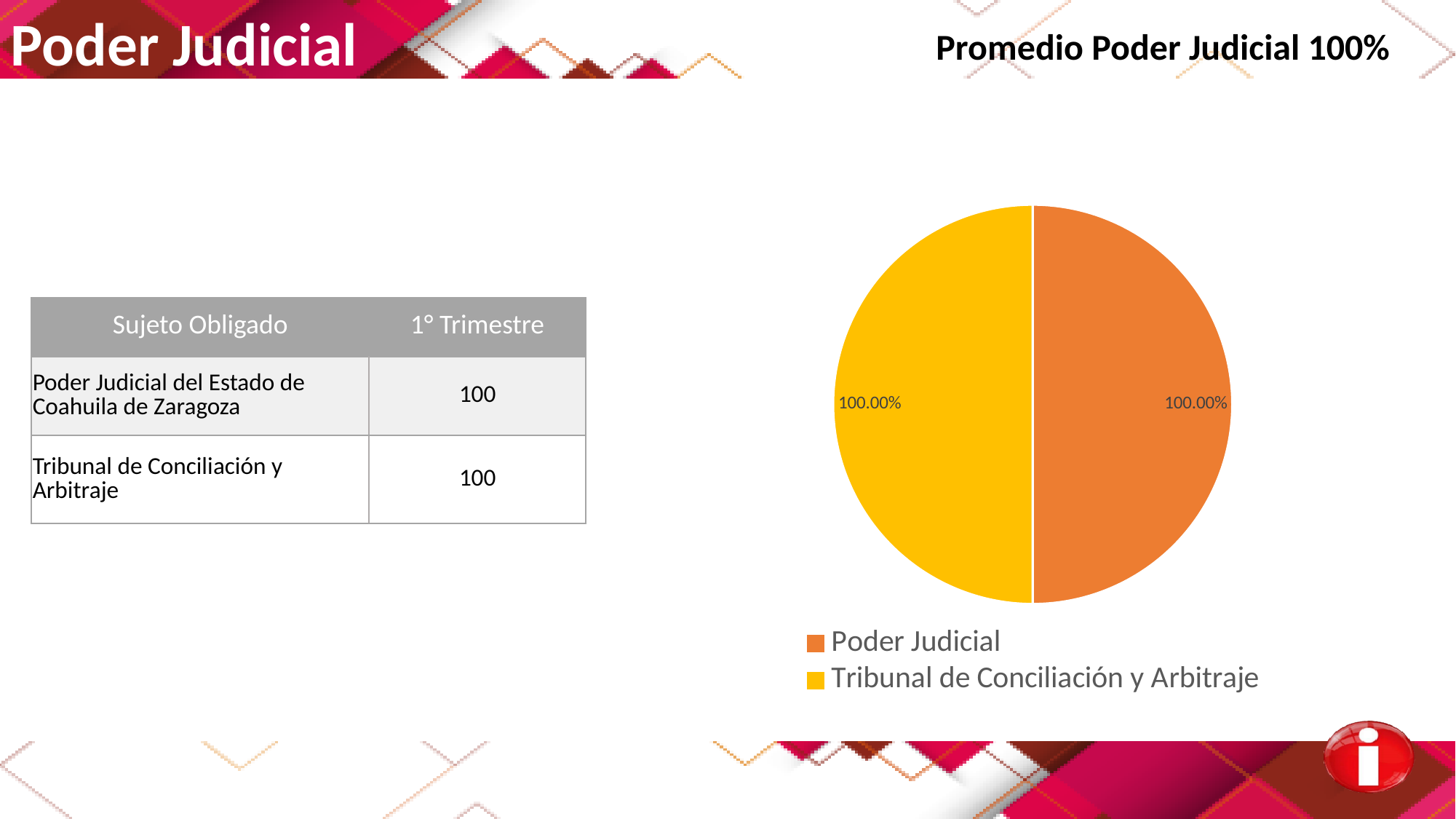
What kind of chart is shown on the slide? pie chart Is the data label on the Poder Judicial slice greater or less than 50%? greater What data label is shown on the Tribunal de Conciliación y Arbitraje slice of the pie chart? 100.00% How many entries does the legend of the pie chart list? 2 Which colour represents Poder Judicial in the pie chart? orange How many slices does the pie chart have? 2 Do the two slices of the pie chart show the same data label value? yes What data label is shown on the Poder Judicial slice of the pie chart? 100.00% Which colour represents Tribunal de Conciliación y Arbitraje in the pie chart? yellow